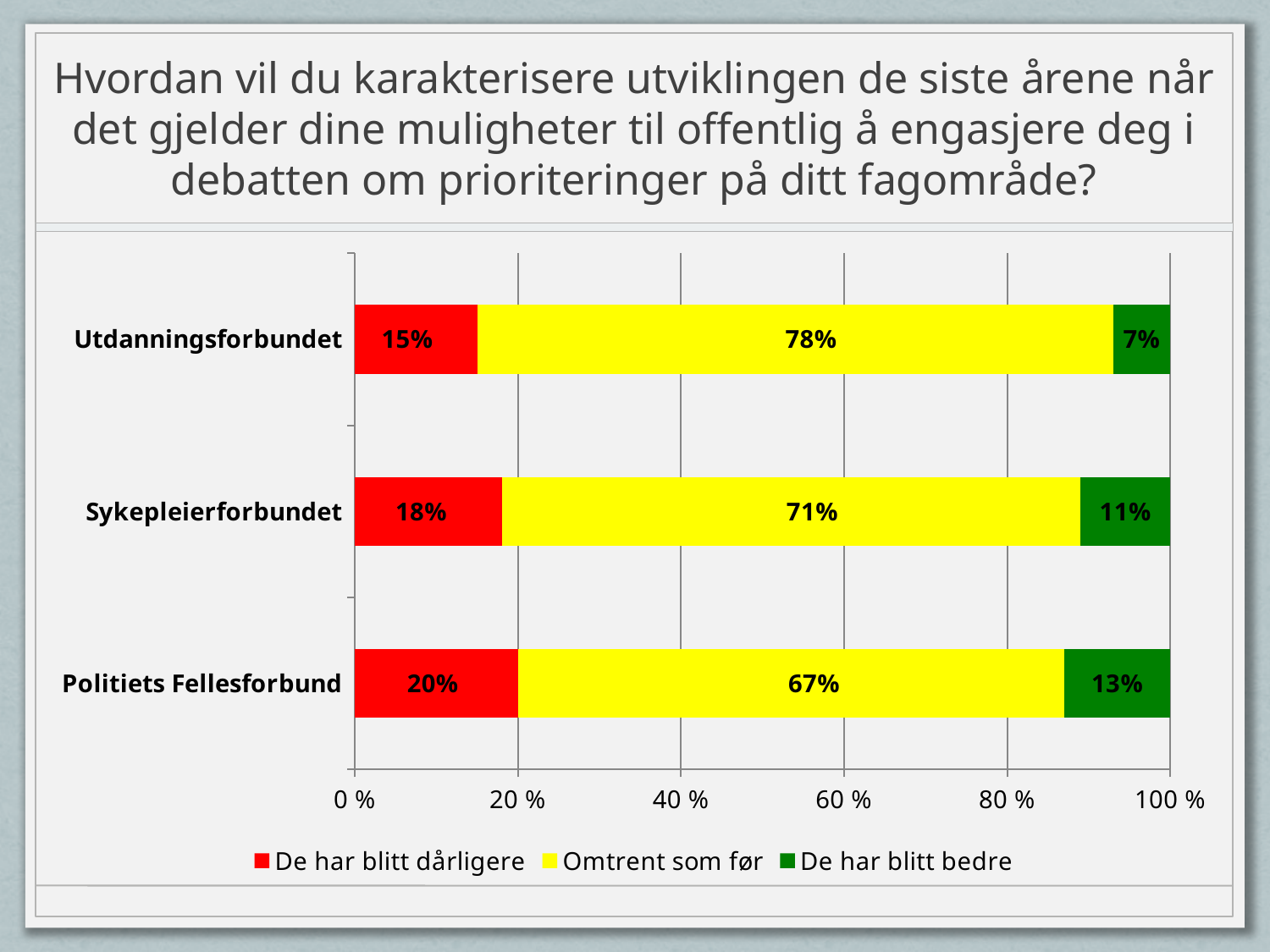
Which category has the highest value for "De har blitt dårligere"? Politiets Fellesforbund What is the value for "De har blitt dårligere" for Sykepleierforbundet? 18% Which colour represents "Omtrent som før" in the legend? Yellow How many categories are shown on the chart? 3 What is the value for "De har blitt bedre" for Politiets Fellesforbund? 13% Which category has the lowest value for "De har blitt bedre"? Utdanningsforbundet What kind of chart is shown on the slide? Stacked bar chart What percentage of Utdanningsforbundet respondents answered "Omtrent som før"? 78% Which is larger: "De har blitt bedre" for Sykepleierforbundet or for Utdanningsforbundet? Sykepleierforbundet What is the total of the stacked bar for Sykepleierforbundet? 100% What is the difference between the "Omtrent som før" values for Utdanningsforbundet and Politiets Fellesforbund? 11% How many series does the legend list? 3